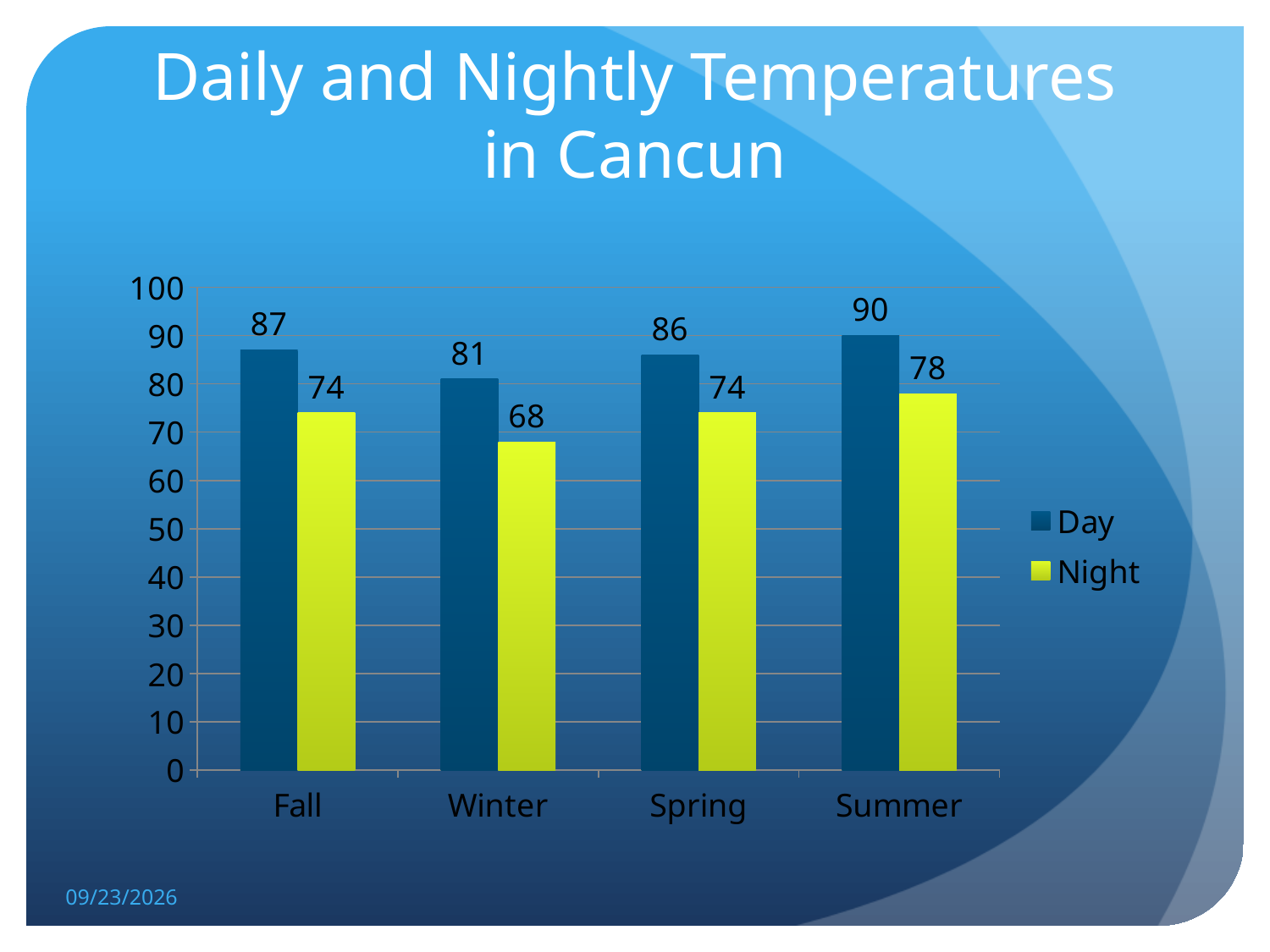
What is the Day temperature for Fall? 87 How many series does the legend list? 2 Which season has the lowest Night temperature? Winter How many seasons are shown on the x axis? 4 What is the difference between the Day and Night temperatures in Spring? 12 What is the difference between the Day temperatures for Summer and Winter? 9 What is the Night temperature for Winter? 68 Which is larger, the Night temperature for Summer or the Night temperature for Fall? Summer What kind of chart is shown on the slide? Bar chart What is the title of the chart? Daily and Nightly Temperatures in Cancun What is the Night temperature for Summer? 78 Which season has the highest Day temperature? Summer